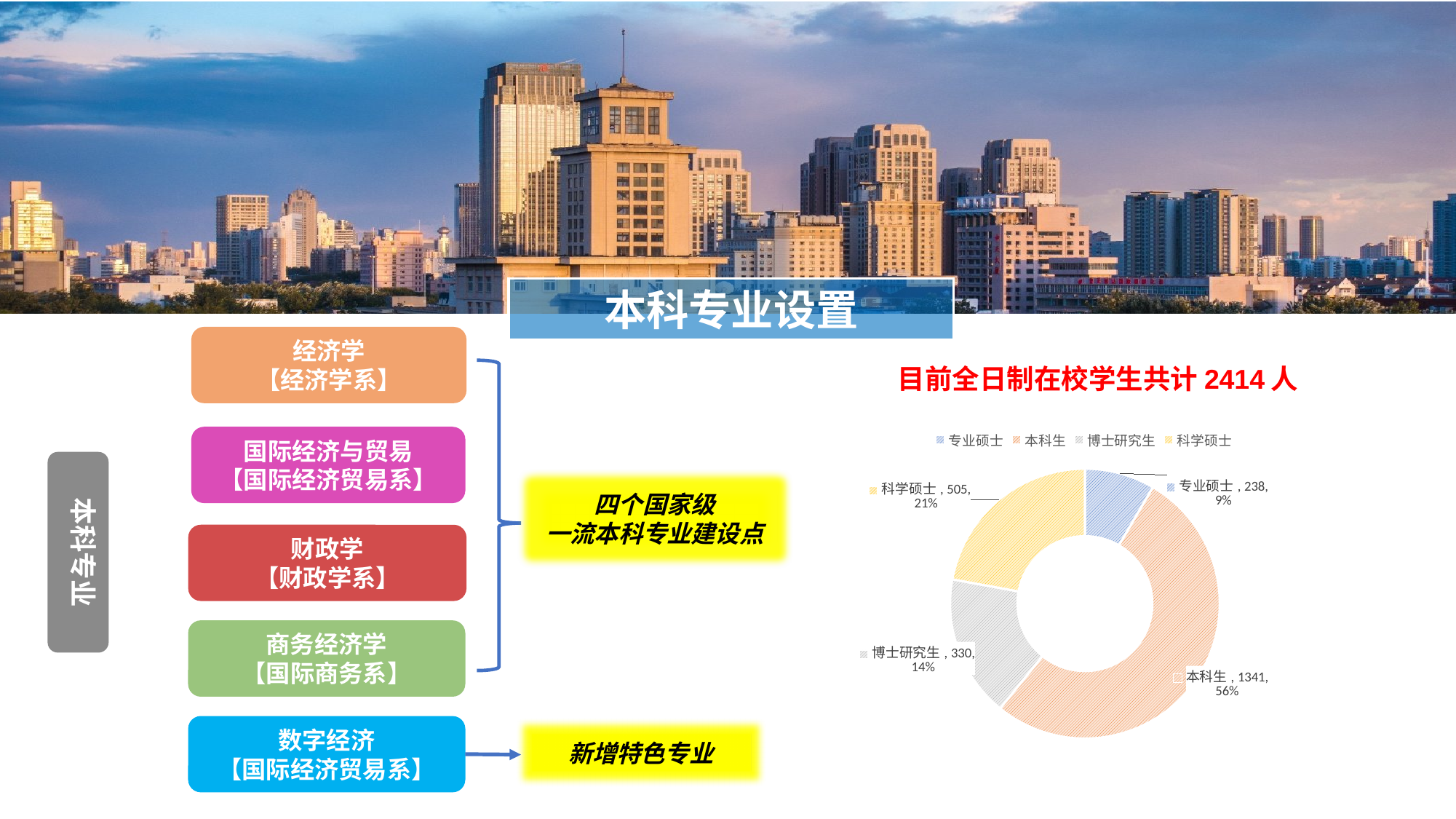
What is the value for 博士研究生 in the doughnut chart? 330 What percentage share does 本科生 have in the doughnut chart? 56% Which category has the largest share in the doughnut chart? 本科生 What is the value for 科学硕士 in the doughnut chart? 505 What percentage share does 科学硕士 have in the doughnut chart? 21% What is the difference between the values for 科学硕士 and 博士研究生 in the doughnut chart? 175 Which is larger in the doughnut chart, 博士研究生 or 专业硕士? 博士研究生 How many categories does the doughnut chart show? 4 What is the value for 本科生 in the doughnut chart? 1341 Which category has the smallest share in the doughnut chart? 专业硕士 What is the value for 专业硕士 in the doughnut chart? 238 What type of chart is shown on the slide? Doughnut chart